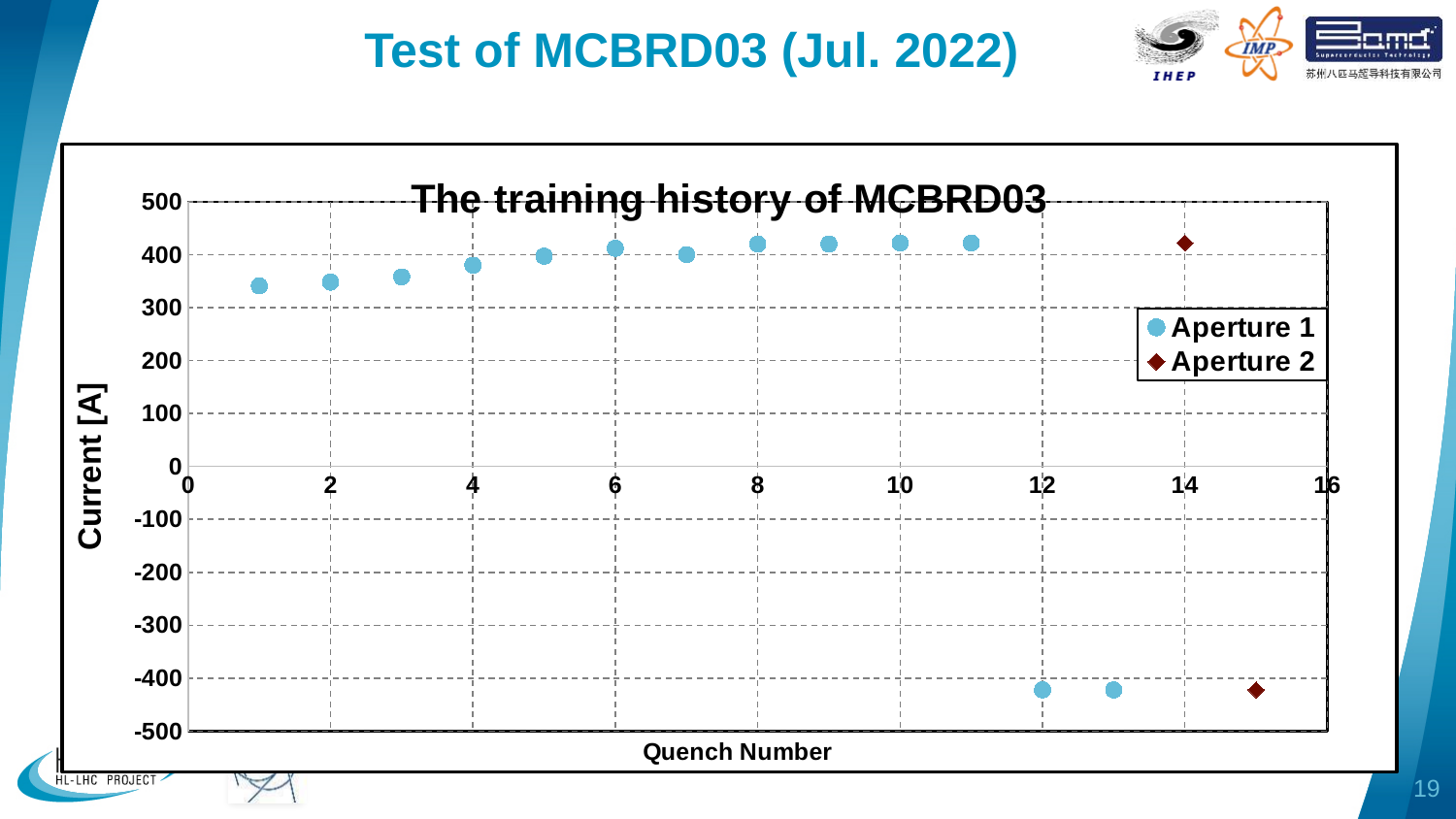
How many data points are plotted for Aperture 1? 13 Is the Aperture 1 current at quench number 12 greater or less than -400 A? less Is the Aperture 1 current at quench number 1 greater or less than 300 A? greater How many series does the legend list? 2 What are the two series named in the legend? Aperture 1 and Aperture 2 How many data points are plotted for Aperture 2? 2 What kind of chart is shown on the slide? scatter chart Is the Aperture 1 current at quench number 1 greater or less than 400 A? less Which of the two Aperture 1 points, quench number 1 or quench number 11, has the higher current? quench number 11 Does the Aperture 1 current rise or fall from quench number 1 to quench number 6? rise What is the title of the chart? The training history of MCBRD03